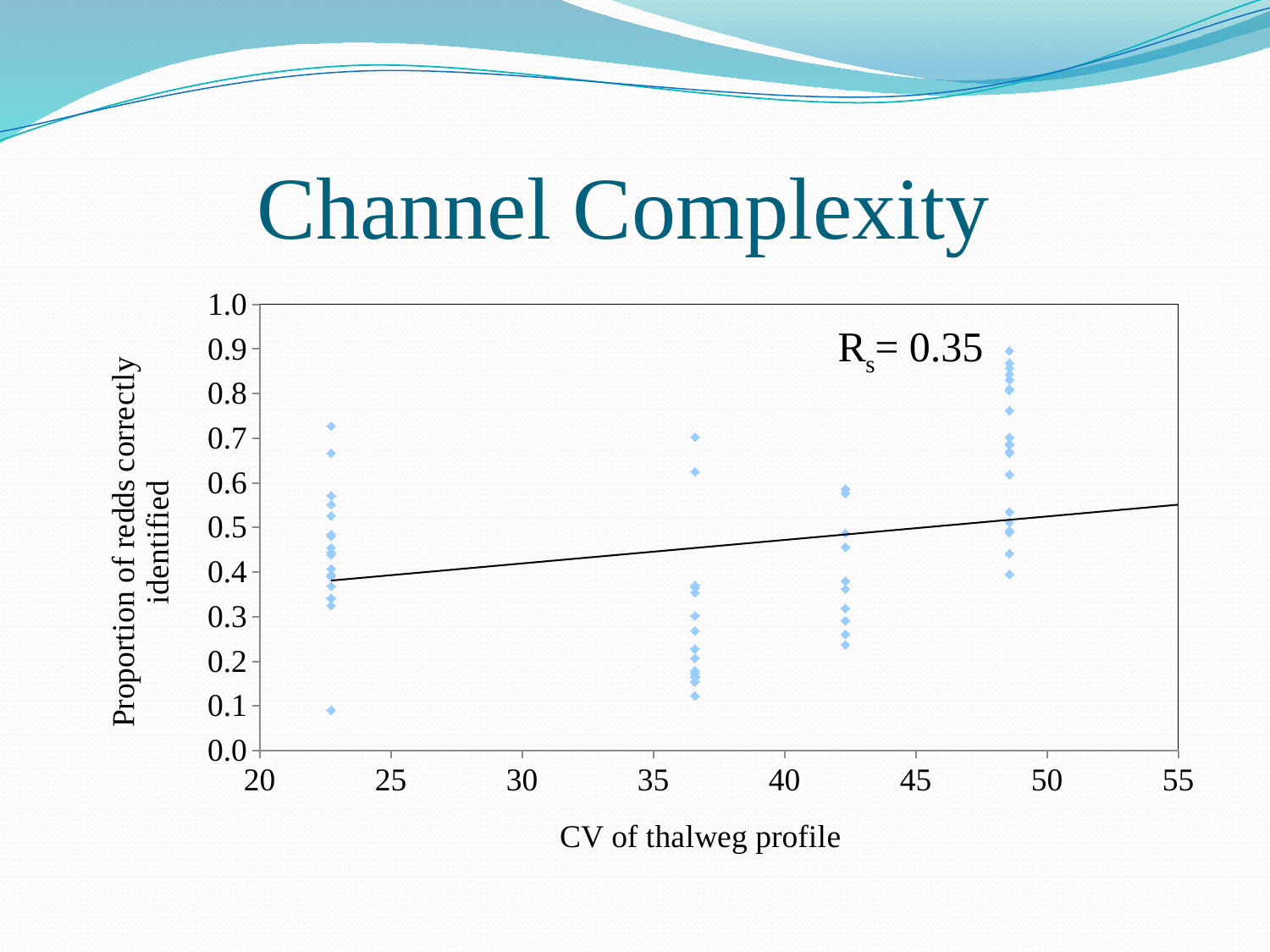
Is the lowest plotted proportion of redds correctly identified greater or less than 0.2? less Is the highest point in the cluster between 40 and 45 on the x axis greater or less than 0.5? greater Which cluster of points contains the lowest proportion value: the one between 35 and 40 or the one between 40 and 45 on the x axis? the one between 35 and 40 Which cluster of points contains the highest proportion value: the one between 20 and 25 or the one between 45 and 50 on the x axis? the one between 45 and 50 What is the title of the chart? Channel Complexity Is the highest plotted proportion of redds correctly identified greater or less than 0.8? greater Does the fitted line rise or fall as CV of thalweg profile increases? rises What value of Rs is printed on the chart? 0.35 What kind of chart is shown on the slide? scatter chart At how many distinct x-values are the data points clustered? 4